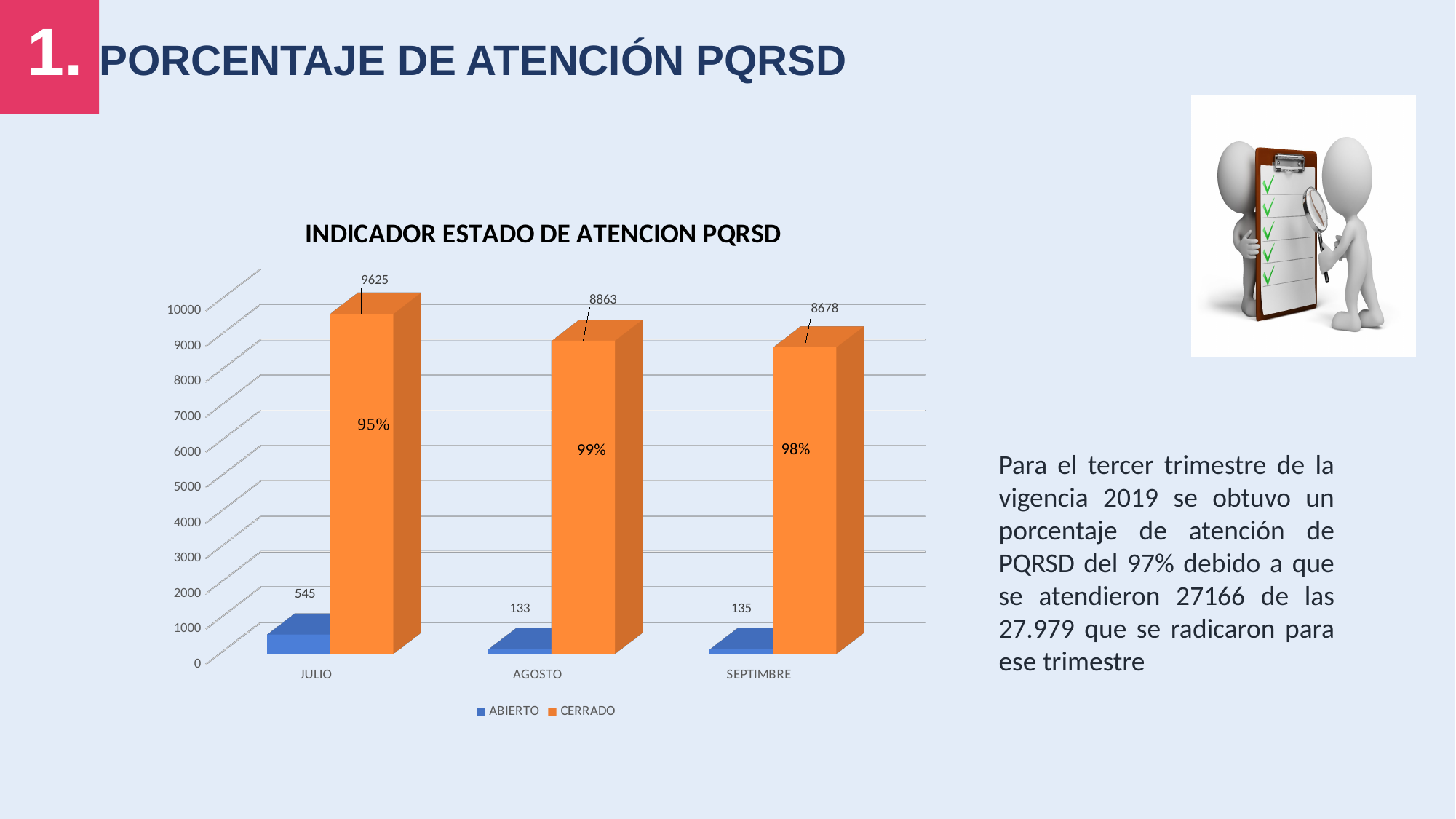
How many months are shown on the x axis? 3 How many series does the legend list? 2 Which month has the lowest ABIERTO value? AGOSTO Which is larger, the ABIERTO value for SEPTIMBRE or the ABIERTO value for AGOSTO? SEPTIMBRE What percentage label is shown on the CERRADO bar for AGOSTO? 99% Which month has the highest CERRADO value? JULIO What is the CERRADO value for SEPTIMBRE? 8678 What is the CERRADO value for JULIO? 9625 What is the ABIERTO value for AGOSTO? 133 What is the ABIERTO value for JULIO? 545 What is the difference between the CERRADO values for JULIO and AGOSTO? 762 What kind of chart is shown? Bar chart